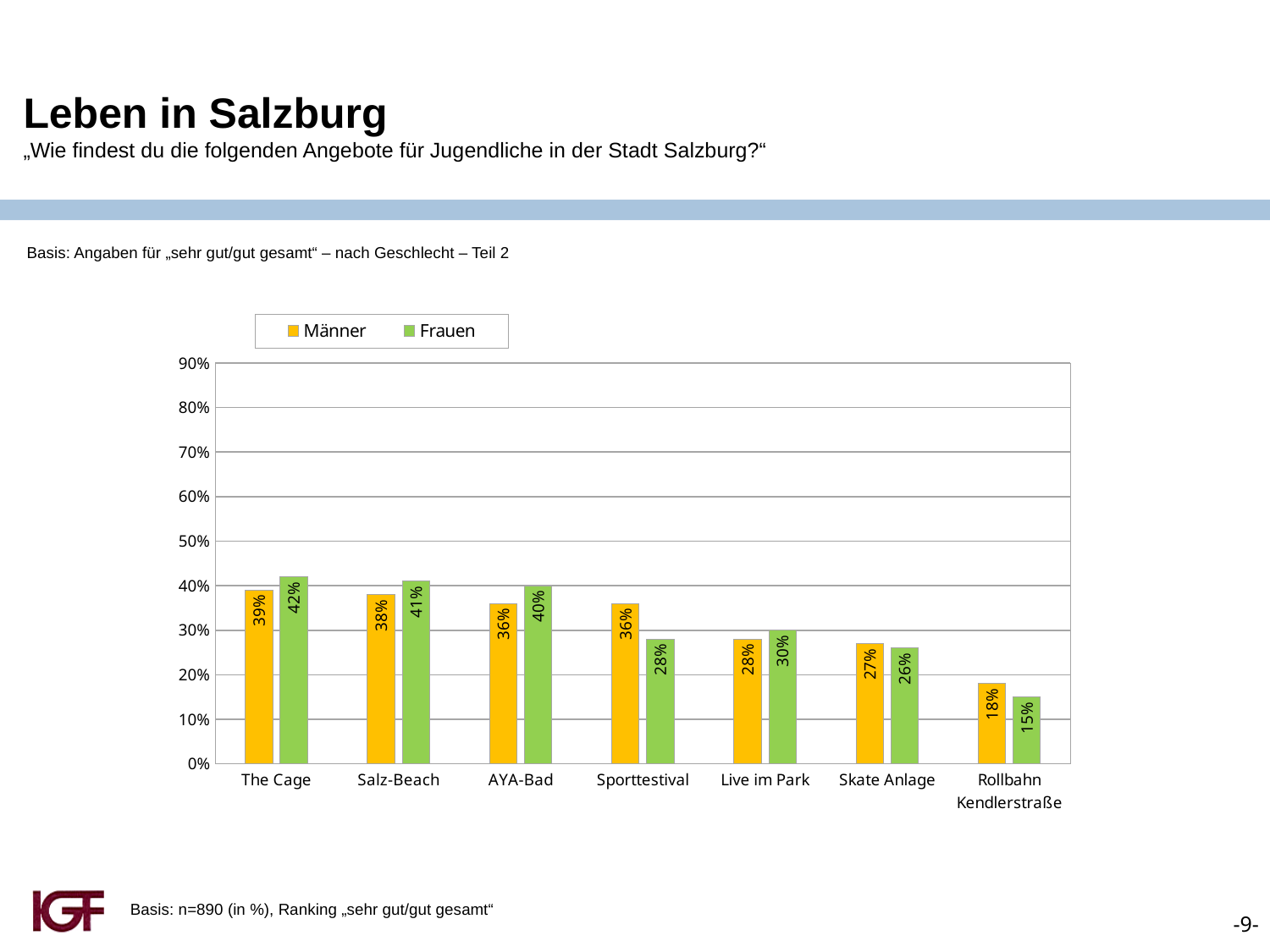
What is the value for Männer for The Cage? 39% What is the value for Frauen for AYA-Bad? 40% What is the difference between the Männer and Frauen values for Sporttestival? 8% For Live im Park, which is larger: the Männer value or the Frauen value? Frauen How many series does the legend list? 2 Which category has the lowest value for Männer? Rollbahn Kendlerstraße What is the value for Frauen for Rollbahn Kendlerstraße? 15% Do the Männer values rise or fall from The Cage to Rollbahn Kendlerstraße along the x axis? Fall Which category has the highest value for Frauen? The Cage How many categories are shown on the x axis? 7 Which series is shown in green in the legend? Frauen What kind of chart is shown on the slide? Bar chart